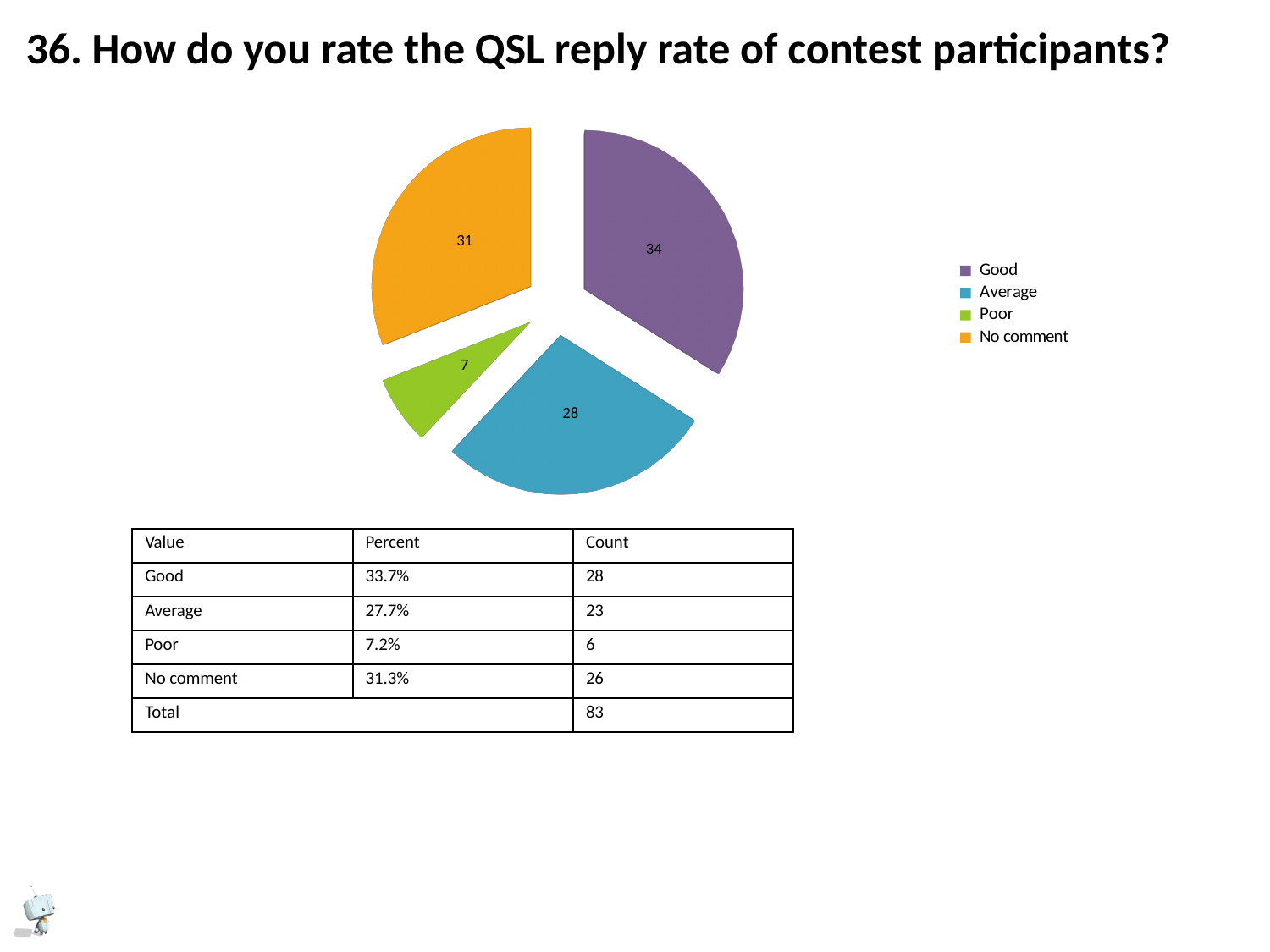
What type of chart is shown on the slide? pie chart What is the difference between the Good and Average slice labels in the pie chart? 6 Which slice is larger in the pie chart, No comment or Average? No comment What colour is the Poor slice in the pie chart? green How many slices does the pie chart have? 4 What is the data label on the Average slice of the pie chart? 28 What is the data label on the Poor slice of the pie chart? 7 What is the data label on the Good slice of the pie chart? 34 Which category has the smallest slice in the pie chart? Poor What is the data label on the No comment slice of the pie chart? 31 How many entries does the legend of the pie chart list? 4 Which category has the largest slice in the pie chart? Good